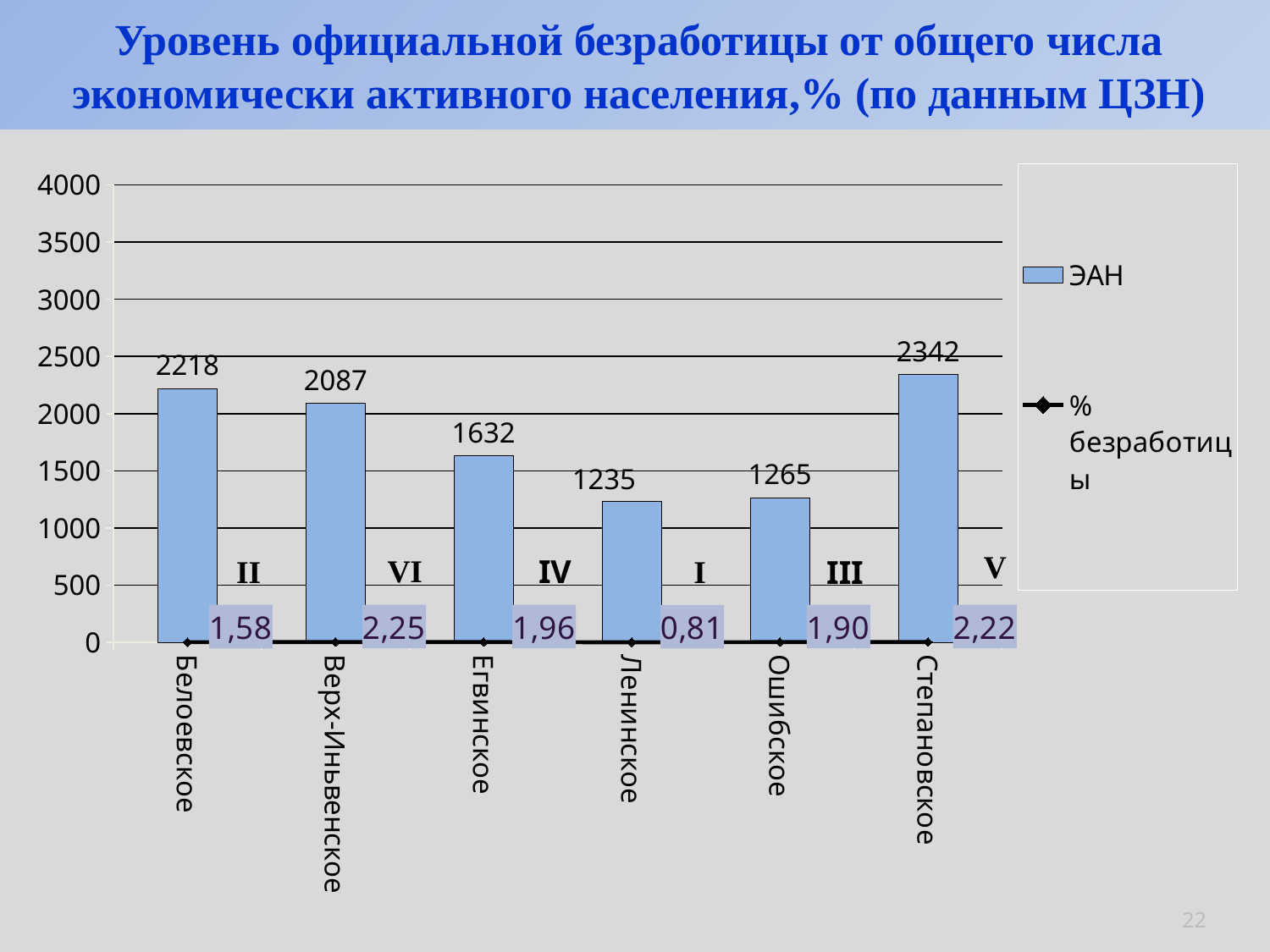
Which category has the highest ЭАН value? Степановское Which category has the lowest % безработицы value? Ленинское Is the ЭАН value for Верх-Иньвенское greater or less than 2500? less How many categories are shown on the x axis? 6 What is the ЭАН value for Белоевское? 2218 What is the % безработицы value for Верх-Иньвенское? 2,25 How many series does the legend list? 2 Which has a higher ЭАН value, Егвинское or Ошибское? Егвинское What are the two series named in the legend? ЭАН and % безработицы What is the ЭАН value for Степановское? 2342 What is the % безработицы value for Ленинское? 0,81 What is the difference in ЭАН between Степановское and Ленинское? 1107